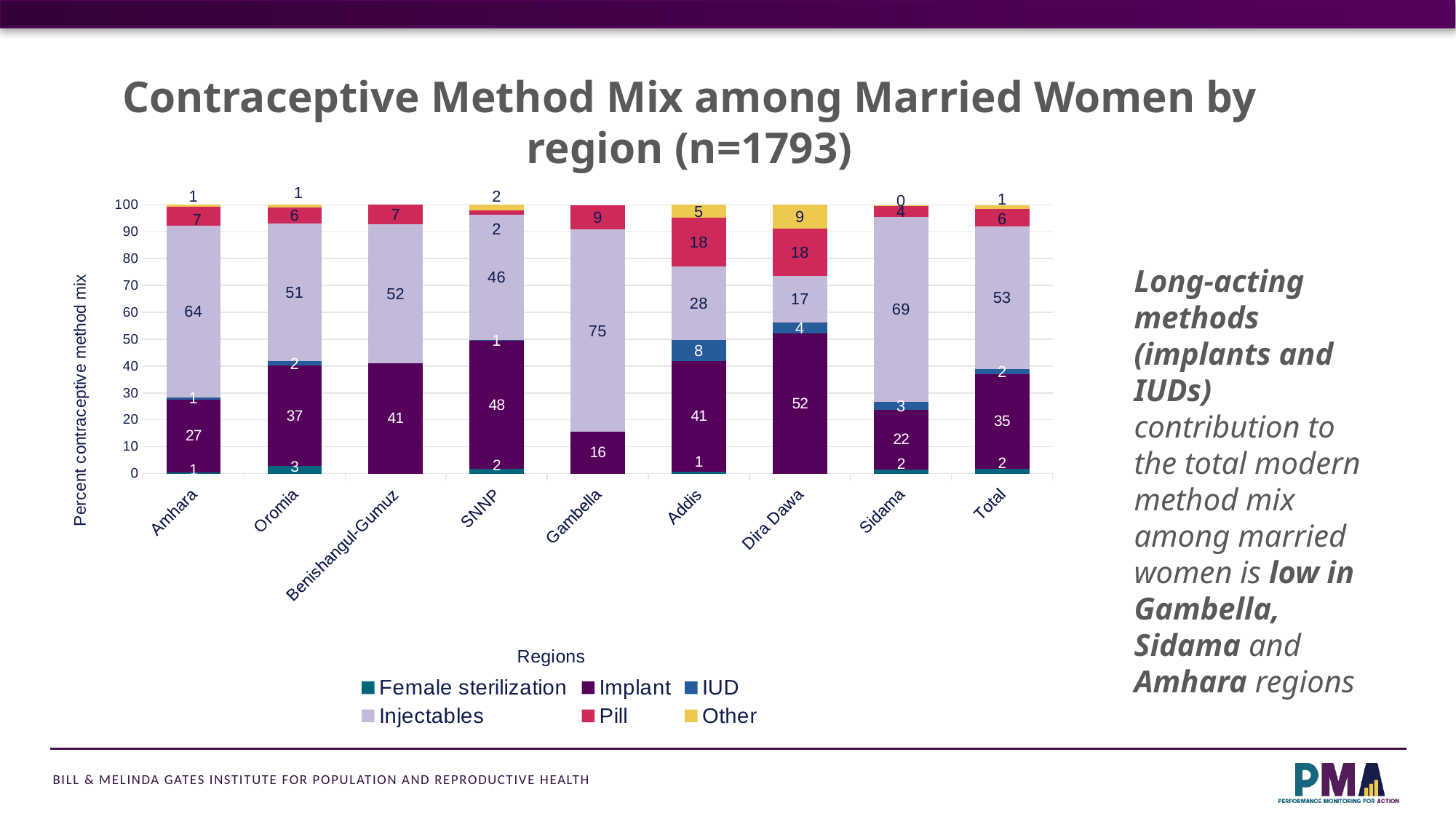
Which is larger, the Implant value for SNNP or the Implant value for Oromia? SNNP What is the difference between the Pill value for Addis and the Pill value for Amhara? 11 What is the Injectables value for Gambella? 75 Which region has the lowest Implant value? Gambella What kind of chart is shown on the slide? Stacked bar chart What is the IUD value for the Total bar? 2 What is the Implant value for Dira Dawa? 52 What is the Pill value for Addis? 18 Which region has the highest Injectables value? Gambella What is the label of the y axis? Percent contraceptive method mix How many regions (categories) are shown on the x axis, including Total? 9 How many series does the legend list? 6